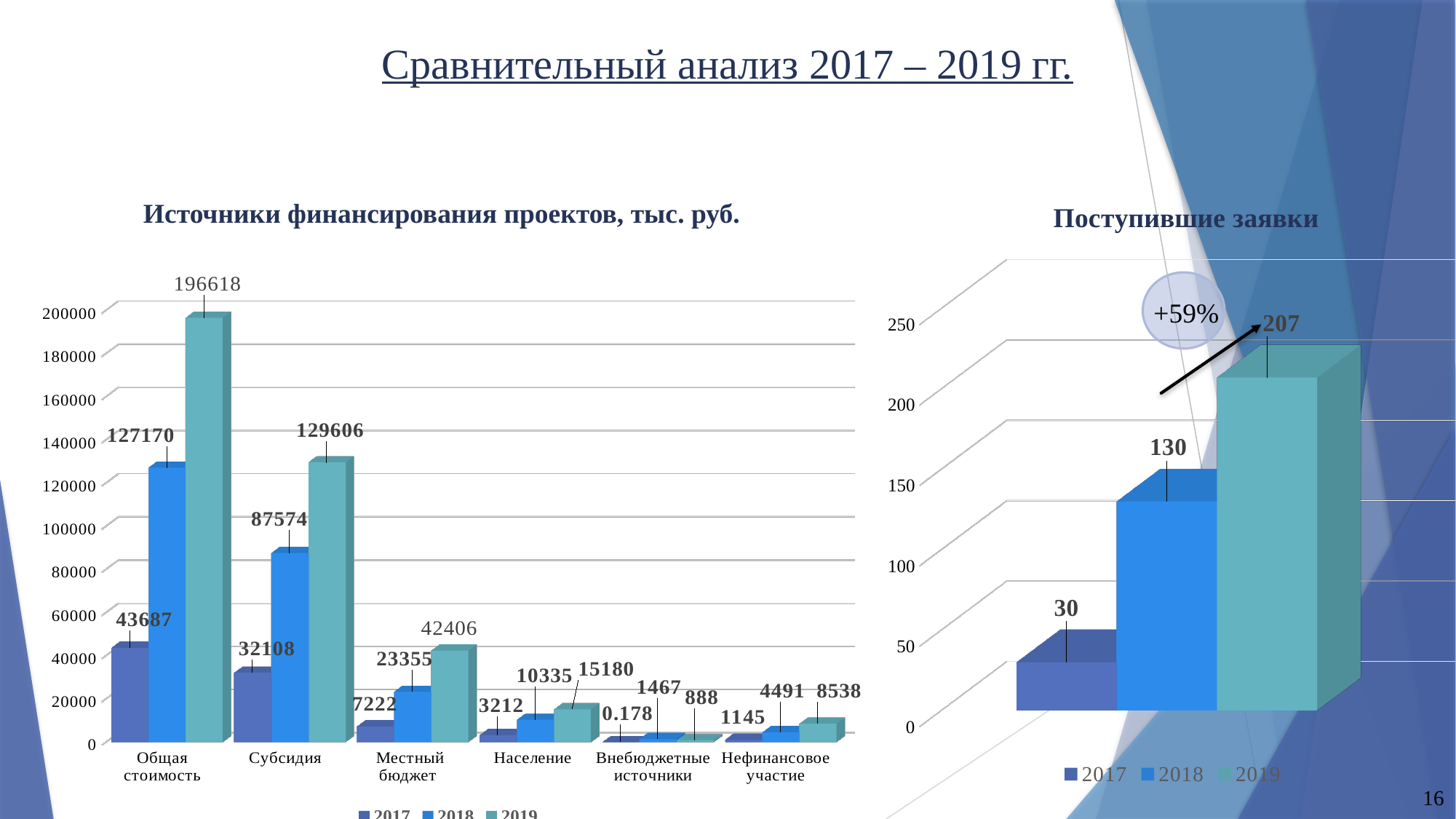
What kind of chart is 'Поступившие заявки'? bar chart In the chart 'Поступившие заявки', do the values rise or fall from 2017 to 2019? rise In the chart 'Источники финансирования проектов, тыс. руб.', what is the value for Общая стоимость in 2019? 196618 In the chart 'Поступившие заявки', what is the value for 2018? 130 In the chart 'Источники финансирования проектов, тыс. руб.', which category has the lowest value for 2019? Внебюджетные источники In the chart 'Источники финансирования проектов, тыс. руб.', which is larger for Внебюджетные источники: the 2018 value or the 2019 value? 2018 How many categories are shown on the x axis of the chart 'Источники финансирования проектов, тыс. руб.'? 6 In the chart 'Источники финансирования проектов, тыс. руб.', what is the value for Внебюджетные источники in 2017? 0.178 In the chart 'Источники финансирования проектов, тыс. руб.', what is the difference between the 2019 and 2018 values for Местный бюджет? 19051 In the chart 'Поступившие заявки', what is the difference between the 2019 and 2017 values? 177 In the chart 'Источники финансирования проектов, тыс. руб.', what is the value for Субсидия in 2018? 87574 How many series does the legend of the chart 'Источники финансирования проектов, тыс. руб.' list? 3